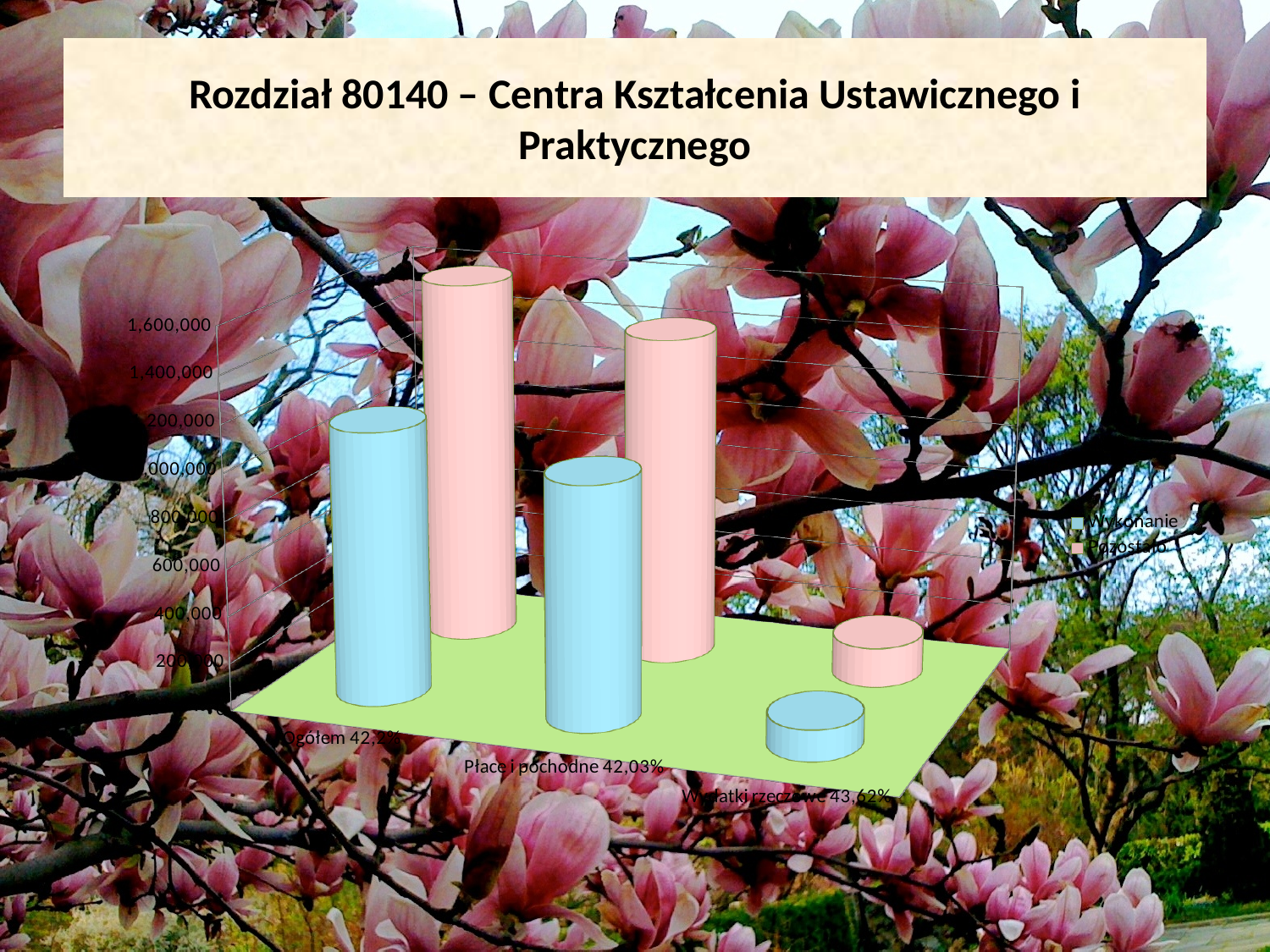
Is the Wykonanie value for Wydatki rzeczowe greater or less than 400,000? less For Ogółem, which is larger: Wykonanie or Pozostało? Pozostało How many categories are shown on the chart's x axis? 3 Which category has the lowest Wykonanie value? Wydatki rzeczowe Which category and series has the tallest bar on the chart? Pozostało for Ogółem How many series does the chart legend list? 2 Do the Wykonanie values rise or fall moving from Ogółem to Wydatki rzeczowe along the x axis? fall What are the two series named in the chart legend? Wykonanie and Pozostało What kind of chart is shown on the slide? bar chart For Płace i pochodne, which is larger: Wykonanie or Pozostało? Pozostało What percentage is shown in the category label for Wydatki rzeczowe? 43,62% Is the Pozostało value for Ogółem greater or less than 1,400,000? greater